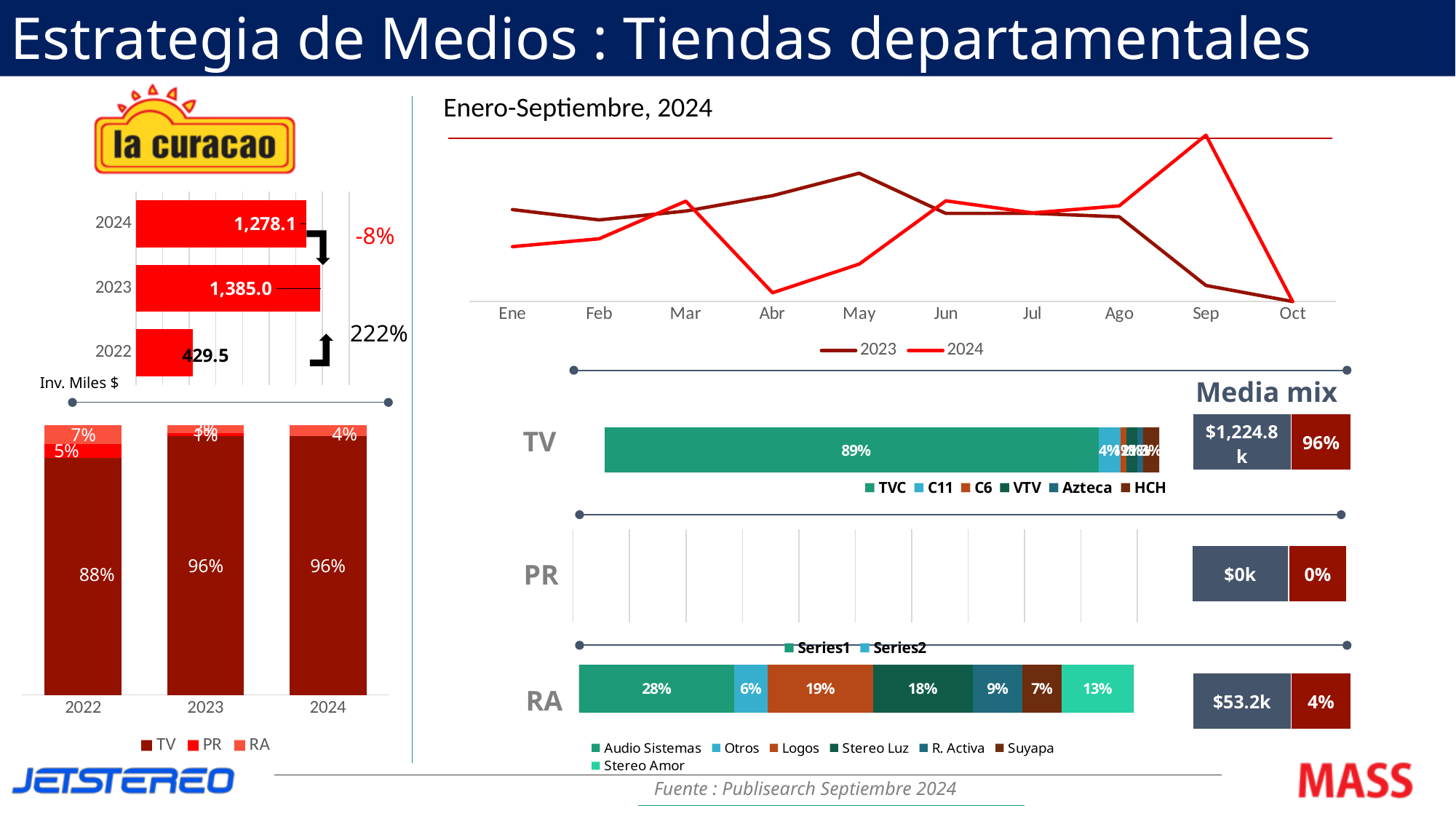
In the line chart titled 'Enero-Septiembre, 2024', how many months are shown on the x axis? 10 What kind of chart is the 'Inv. Miles $' chart on the left? bar chart In the 'Inv. Miles $' bar chart on the left, which year has the lowest investment? 2022 In the stacked bar chart at the bottom left, what is the total of the 2022 bar (TV + PR + RA)? 100% In the 'Inv. Miles $' bar chart on the left, what is the difference between the 2023 and 2024 values? 106.9 In the TV stacked bar chart, what is the share for TVC? 89% In the 'Inv. Miles $' bar chart on the left, what is the value for 2023? 1,385.0 In the RA stacked bar chart, what is the share for Logos? 19% In the line chart titled 'Enero-Septiembre, 2024', how many series does the legend list? 2 In the RA stacked bar chart, which station has the largest share? Audio Sistemas In the 'Inv. Miles $' bar chart on the left, which year has the highest investment? 2023 In the stacked bar chart at the bottom left, what is the TV share for 2022? 88%